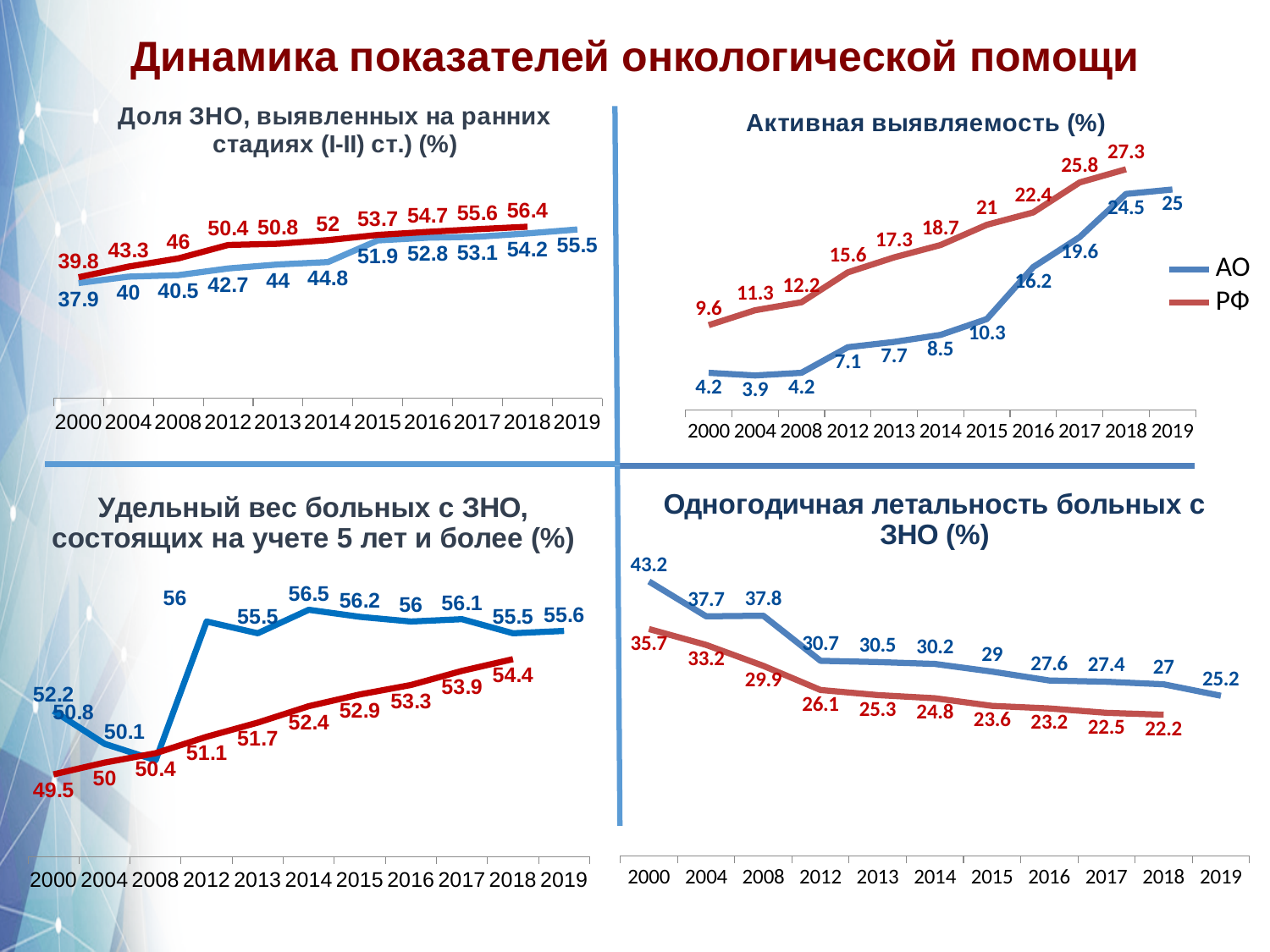
In the top-left chart 'Доля ЗНО, выявленных на ранних стадиях', what is the value of the blue line in 2019? 55.5 In the 'Активная выявляемость (%)' chart, what is the value of the АО series in 2019? 25 In the top-left chart 'Доля ЗНО, выявленных на ранних стадиях', what is the value of the red line in 2000? 39.8 In the 'Активная выявляемость (%)' chart, what is the value of the РФ series in 2018? 27.3 In the bottom-left chart 'Удельный вес больных с ЗНО, состоящих на учете 5 лет и более', what is the value of the red line in 2018? 54.4 In the 'Активная выявляемость (%)' chart, what is the difference between the РФ and АО values in 2016? 6.2 In the bottom-left chart 'Удельный вес больных с ЗНО, состоящих на учете 5 лет и более', in which year is the blue line highest? 2014 In the 'Активная выявляемость (%)' chart, how many series does the legend list? 2 In the bottom-right chart 'Одногодичная летальность больных с ЗНО', which is larger in 2012: the blue line or the red line? the blue line In the top-left chart 'Доля ЗНО, выявленных на ранних стадиях', does the blue line generally rise or fall from 2000 to 2019? rise In the 'Активная выявляемость (%)' chart, in which year is the АО series lowest? 2004 In the bottom-right chart 'Одногодичная летальность больных с ЗНО', what is the value of the blue line in 2000? 43.2